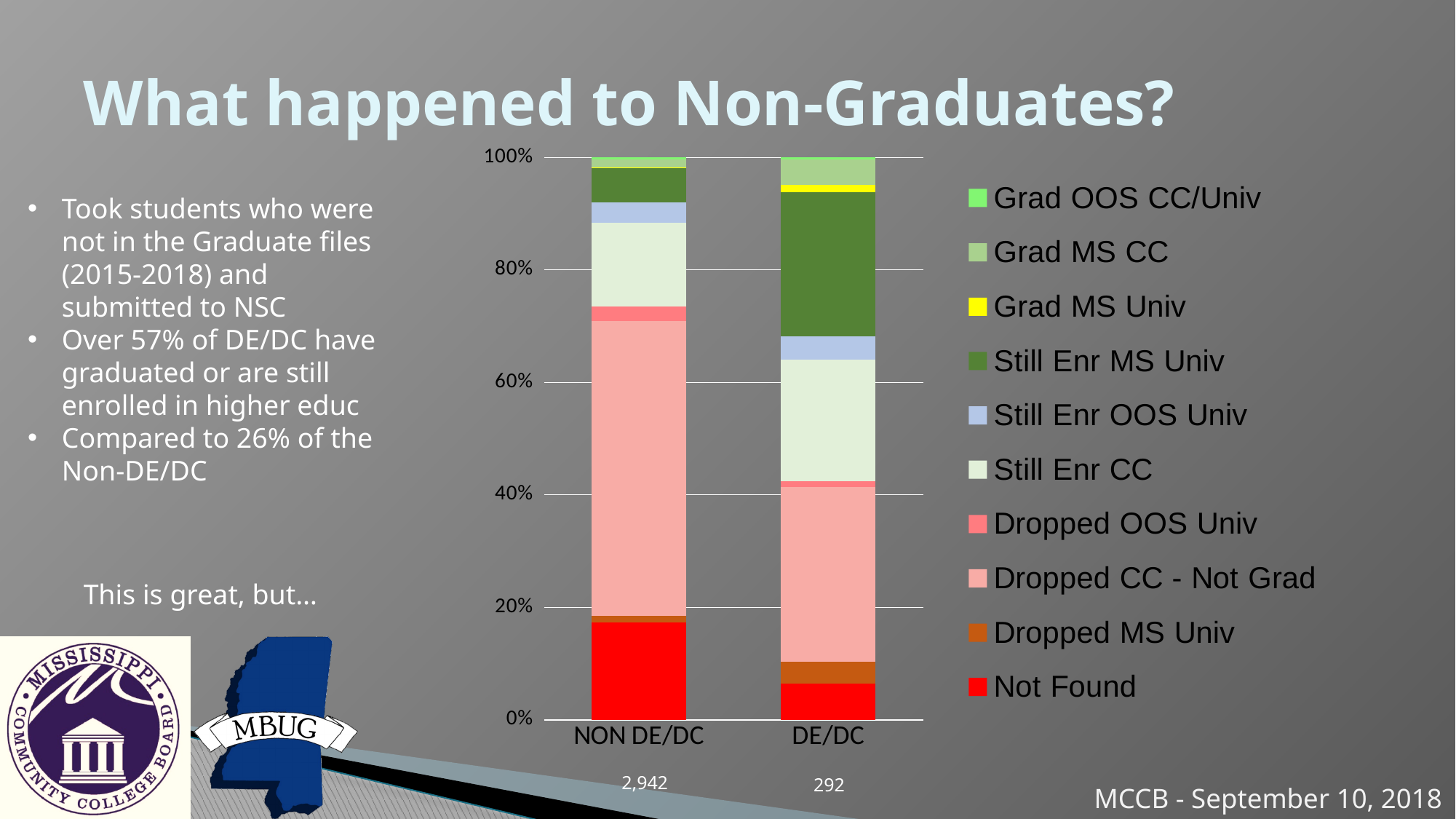
Which category has the larger Still Enr MS Univ segment, NON DE/DC or DE/DC? DE/DC Is the Dropped CC - Not Grad segment for NON DE/DC greater or less than 40%? greater Which legend entry is shown in red? Not Found Which category has the larger Dropped CC - Not Grad segment? NON DE/DC How many series does the chart's legend list? 10 Is the Still Enr MS Univ segment for DE/DC greater or less than 20%? greater Which category has the larger Not Found segment, NON DE/DC or DE/DC? NON DE/DC What value does the top of each stacked bar reach on the y axis? 100% What number is printed below the NON DE/DC bar? 2,942 How many categories are shown on the x axis of the chart? 2 What kind of chart is shown on the slide? Stacked bar chart Is the Not Found segment for NON DE/DC greater or less than 20%? less